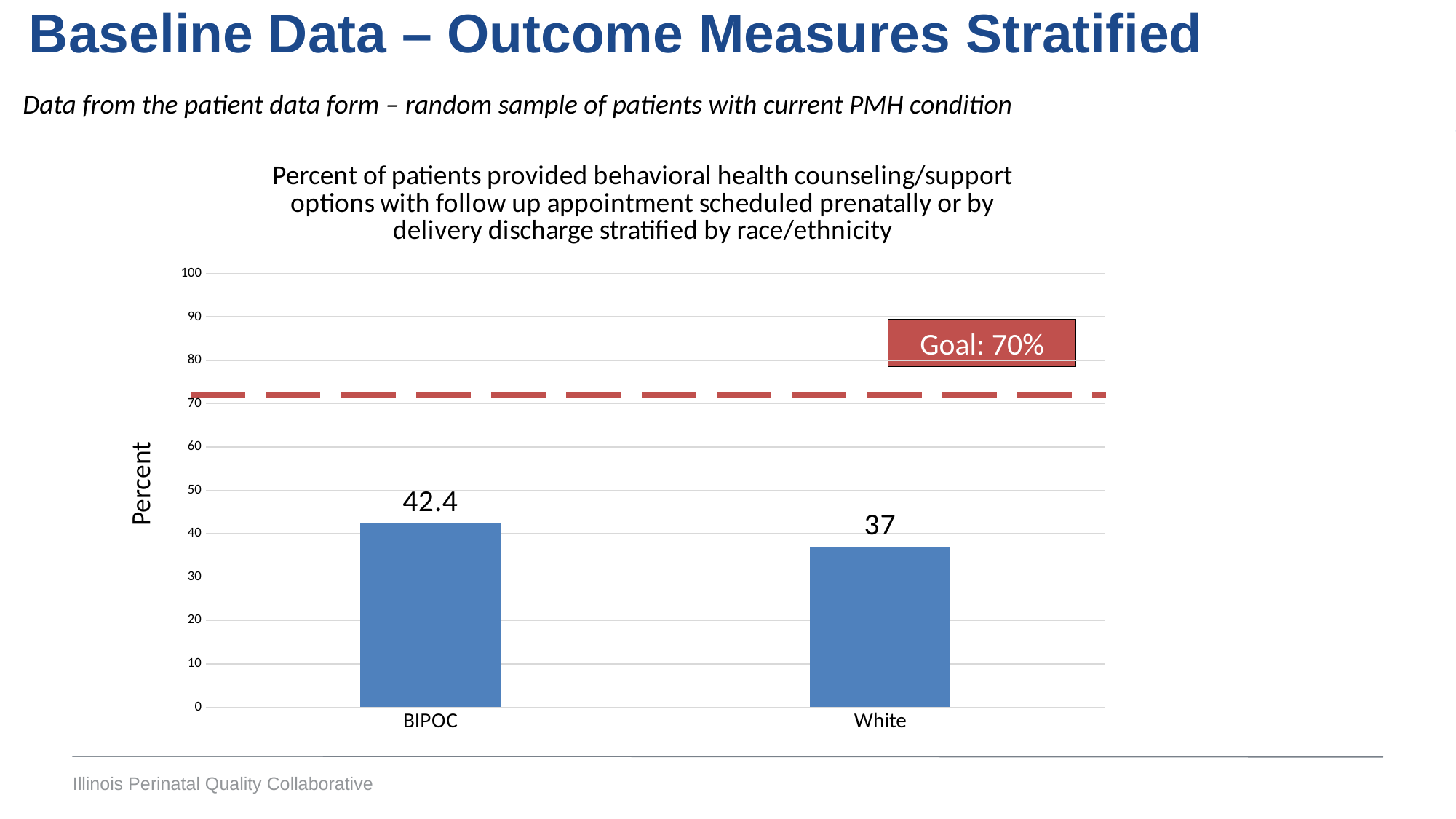
What is the difference between the values for BIPOC and White? 5.4 Is the value for BIPOC greater or less than 50? less What is the value for White? 37 Which category has the highest value? BIPOC What kind of chart is shown on the slide? bar chart What goal value is marked by the dashed line on the chart? 70% What is the label of the y axis? Percent Which category has the lowest value? White Is the value for White greater or less than 30? greater What is the value for BIPOC? 42.4 How many categories are shown on the x axis? 2 Which is larger, the value for BIPOC or the value for White? BIPOC